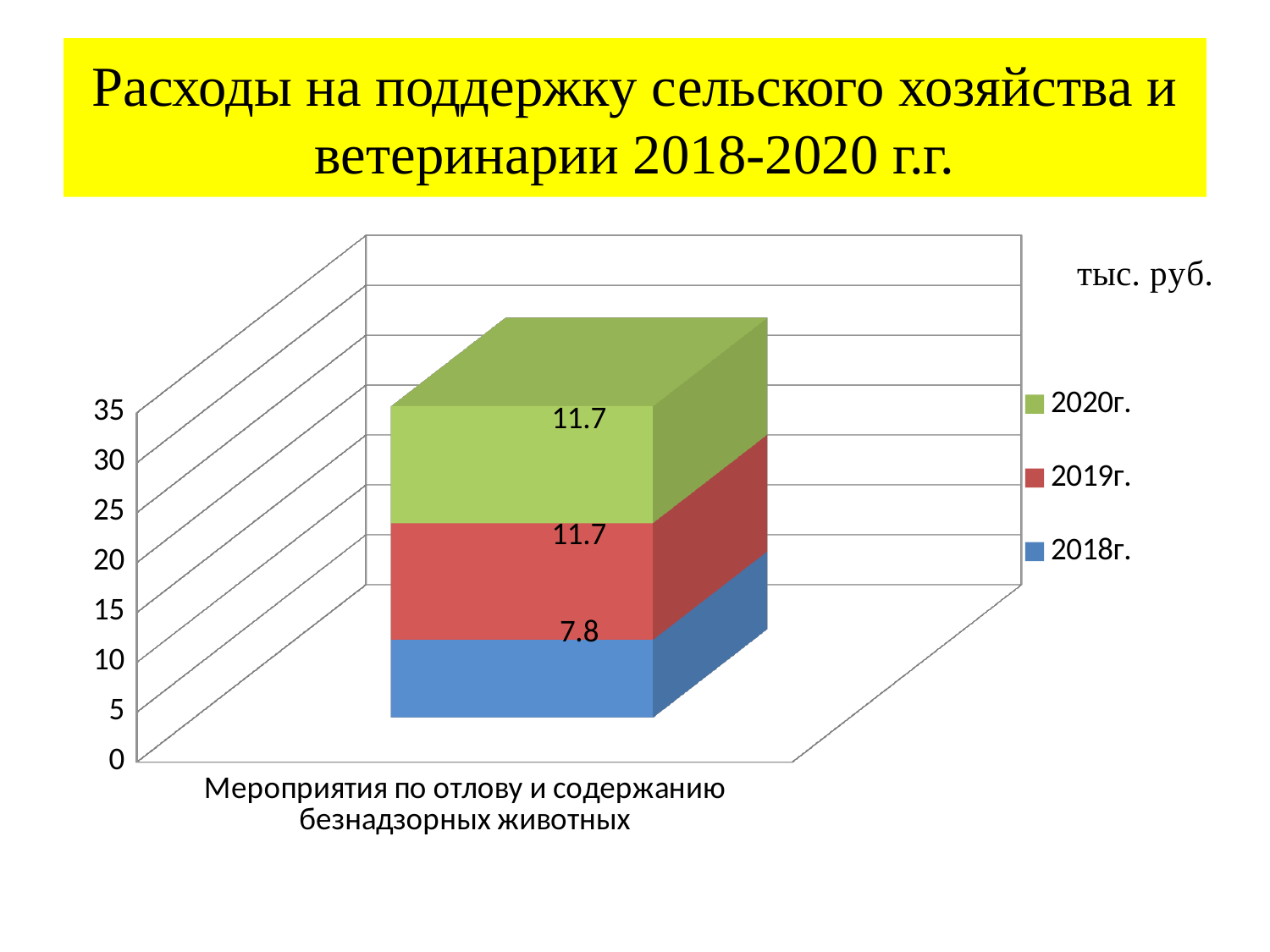
Which year has the lowest value in the chart? 2018г. Which colour represents 2019г. in the chart? Red What kind of chart is shown on the slide? Stacked bar chart What is the value for 2018г. in the chart? 7.8 How many categories are shown on the x axis? 1 What is the difference between the values for 2019г. and 2018г.? 3.9 What is the total of the stacked bar for Мероприятия по отлову и содержанию безнадзорных животных? 31.2 What is the value for 2019г. in the chart? 11.7 What is the value for 2020г. in the chart? 11.7 What unit is indicated next to the chart? тыс. руб. Which is larger, the value for 2018г. or the value for 2020г.? 2020г. How many series does the legend list? 3